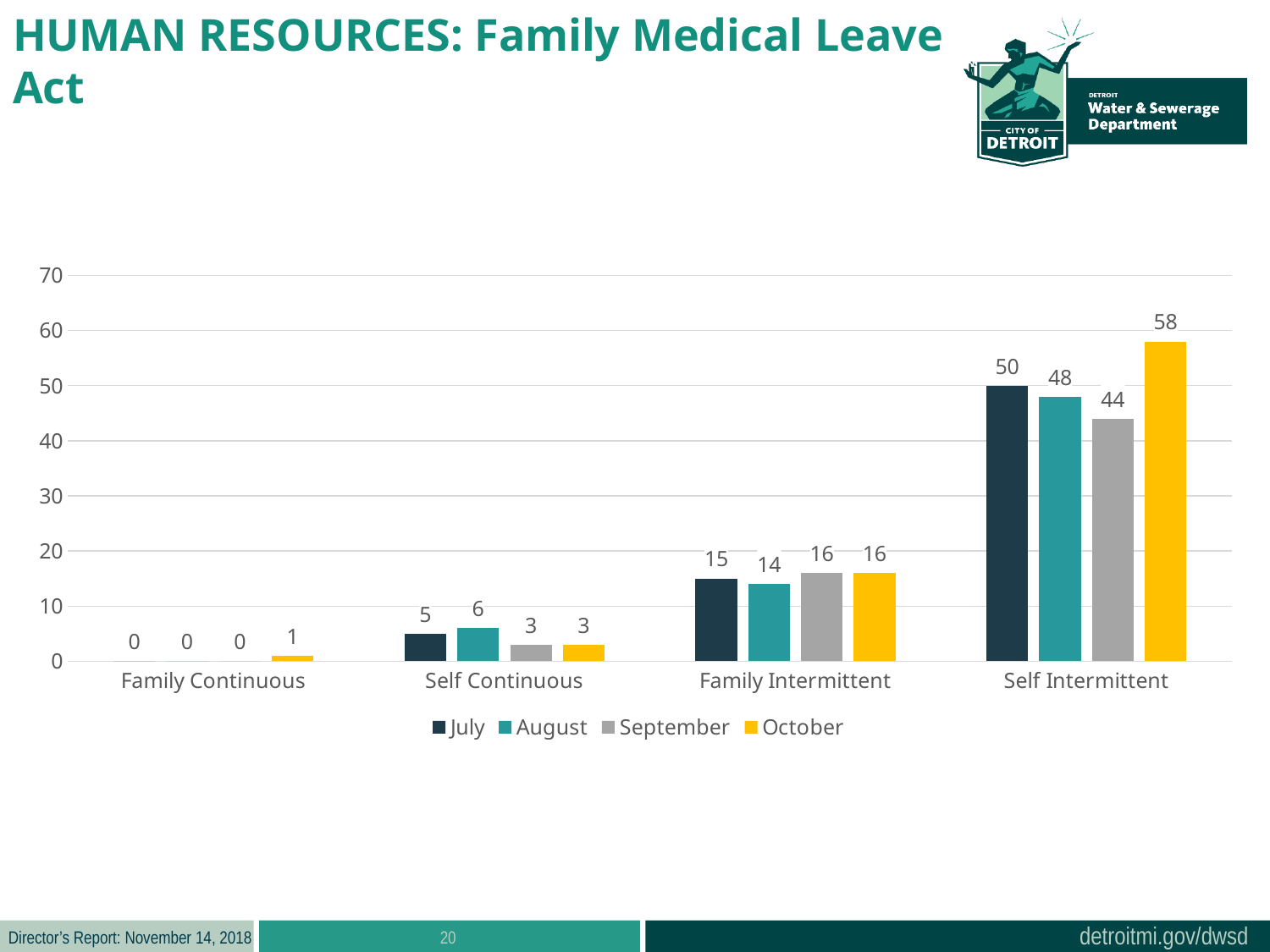
Which category has the lowest value for August? Family Continuous Which category has the highest value for October? Self Intermittent What is the value for September in the Family Intermittent category? 16 How many categories are shown on the x axis? 4 Which month is represented by the yellow bars in the legend? October What is the difference between the October and September values in the Self Intermittent category? 14 What kind of chart is shown on the slide? bar chart How many series does the legend list? 4 Is the value for July in the Self Intermittent category greater or less than 40? greater What is the value for July in the Self Continuous category? 5 Which is larger in the Self Continuous category, the August value or the September value? August What is the value for October in the Self Intermittent category? 58